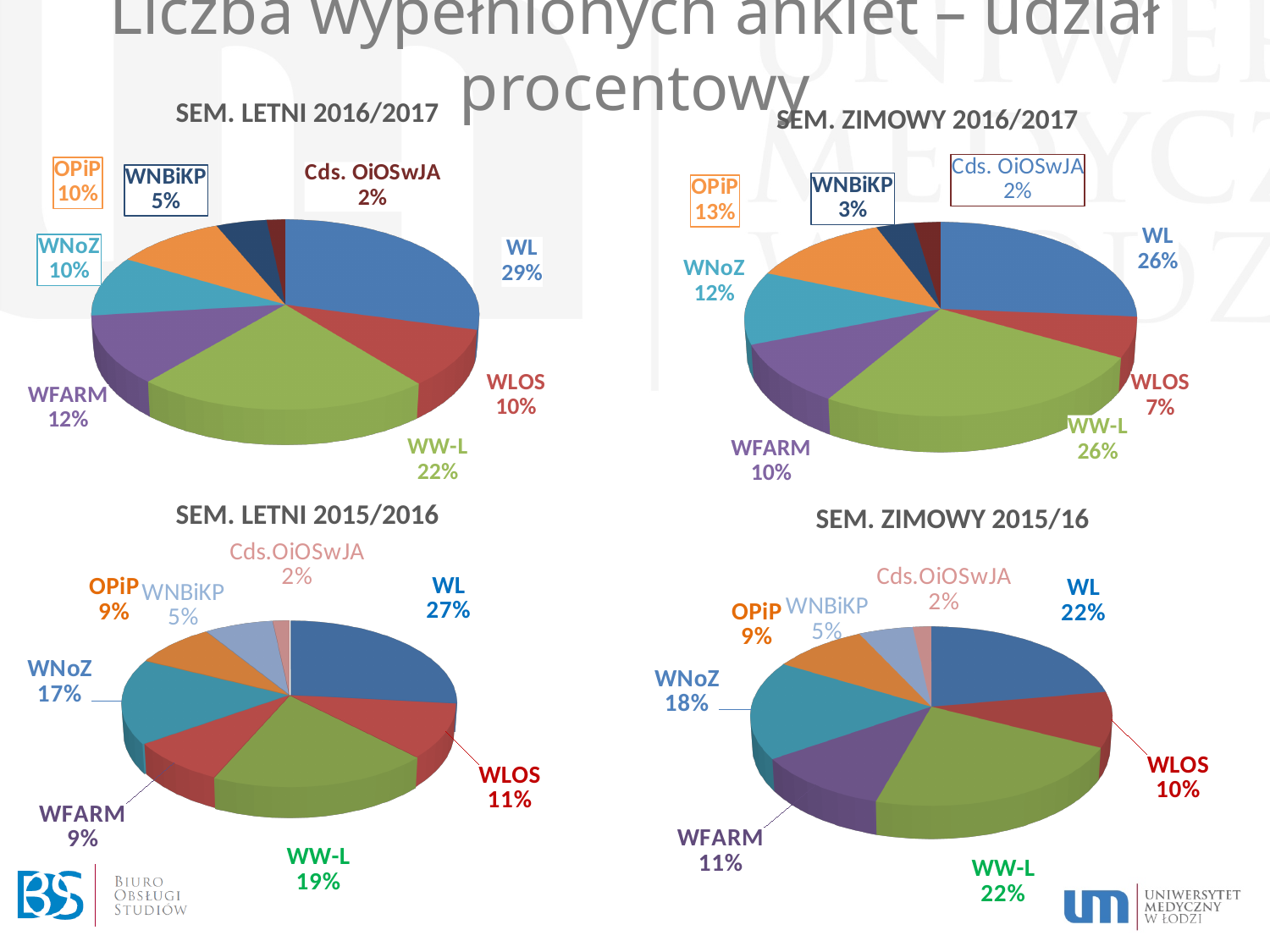
In the SEM. ZIMOWY 2016/2017 chart, what is the difference between the shares of WNoZ and WLOS? 5% In the SEM. LETNI 2015/2016 chart, what share does WNoZ have? 17% How many charts are shown on the slide? 4 In the SEM. ZIMOWY 2015/16 chart, which is larger, the share of WNoZ or the share of WLOS? WNoZ In the SEM. ZIMOWY 2016/2017 chart, what share does OPiP have? 13% How many categories are shown in the SEM. ZIMOWY 2016/2017 chart? 8 In the SEM. ZIMOWY 2016/2017 chart, which category has the smallest share? Cds. OiOSwJA In the SEM. ZIMOWY 2015/16 chart, what share does WFARM have? 11% In the SEM. LETNI 2015/2016 chart, what is the difference between the shares of WL and WW-L? 8% In the SEM. LETNI 2016/2017 chart, which category has the largest share? WL In the SEM. LETNI 2016/2017 chart, what share does WL have? 29% What type of chart is used for SEM. LETNI 2015/2016? Pie chart